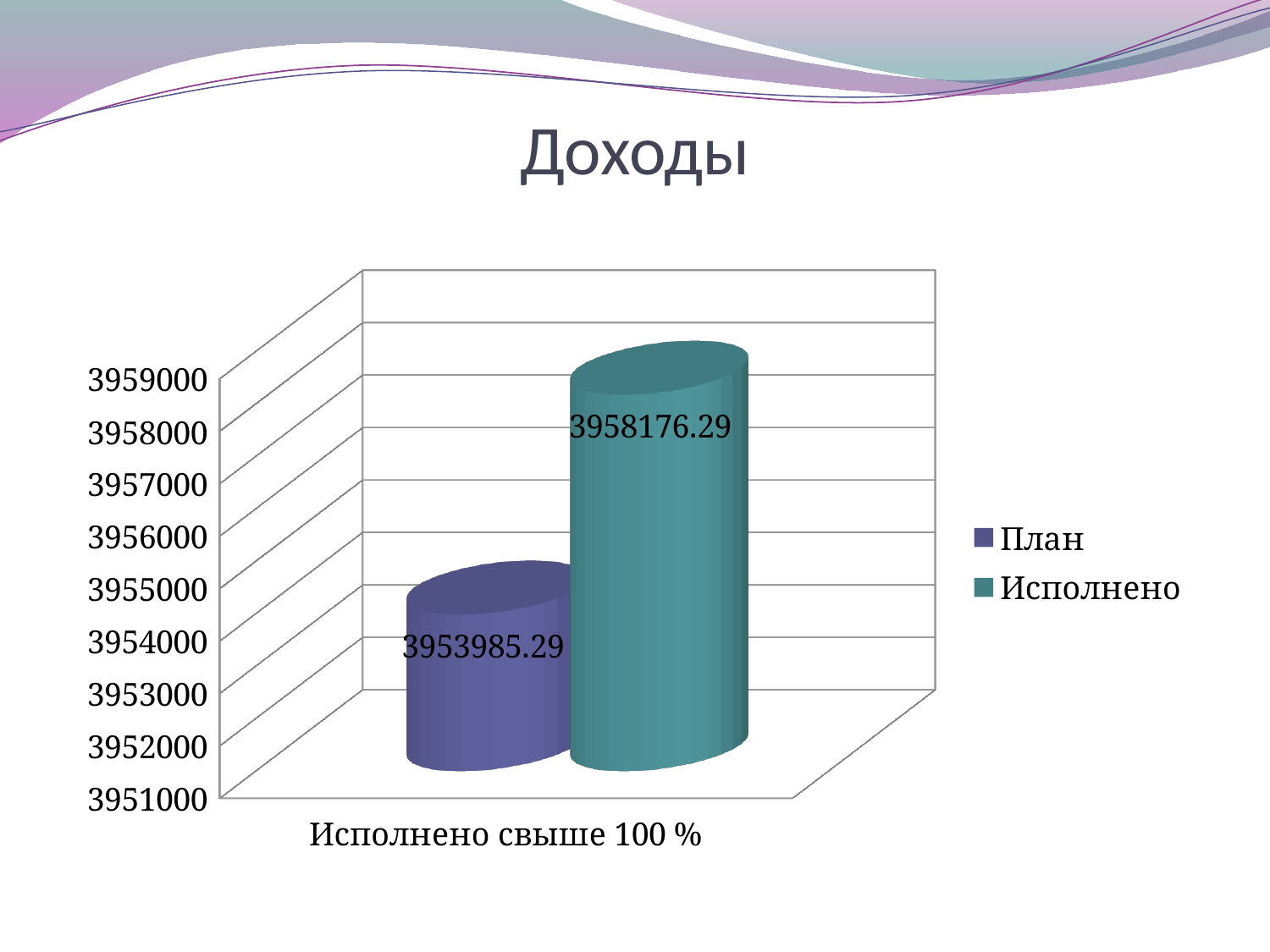
How many series does the legend list? 2 What is the value for План? 3953985.29 Which series has the higher value, План or Исполнено? Исполнено What is the category label shown on the x axis? Исполнено свыше 100 % What kind of chart is shown on the slide? bar chart What is the value for Исполнено? 3958176.29 Is the value for Исполнено greater or less than 3957000? greater What is the difference between the Исполнено value and the План value? 4191 Which series has the lowest value? План Which series has the highest value? Исполнено What is the title of the chart? Доходы Is the value for План greater or less than 3955000? less